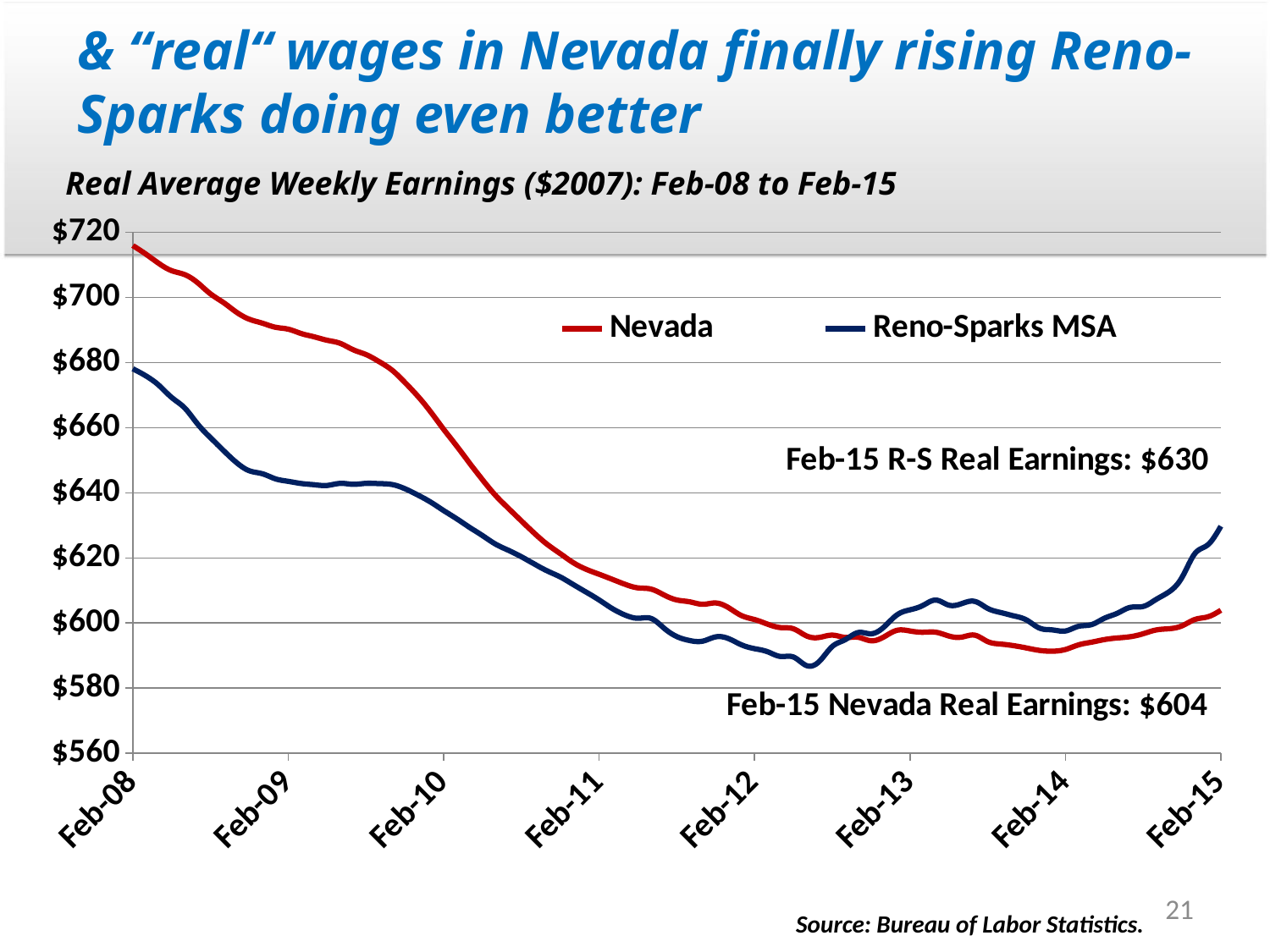
What kind of chart is shown on the slide? line chart Is the value for Nevada at Feb-08 greater or less than $700? greater Do the Nevada real earnings rise or fall from Feb-08 to Feb-12? fall What is the Feb-15 real earnings value for Nevada? $604 What is the title of the chart? Real Average Weekly Earnings ($2007): Feb-08 to Feb-15 At Feb-08, which series has the higher real earnings, Nevada or Reno-Sparks MSA? Nevada How many series does the legend list? 2 What is the Feb-15 real earnings value for Reno-Sparks MSA? $630 What is the difference between the Feb-15 Reno-Sparks real earnings and the Feb-15 Nevada real earnings? $26 Is the value for Reno-Sparks MSA at Feb-08 greater or less than $660? greater Is the value for Nevada at Feb-10 greater or less than $640? greater At Feb-15, which series has the higher real earnings, Nevada or Reno-Sparks MSA? Reno-Sparks MSA